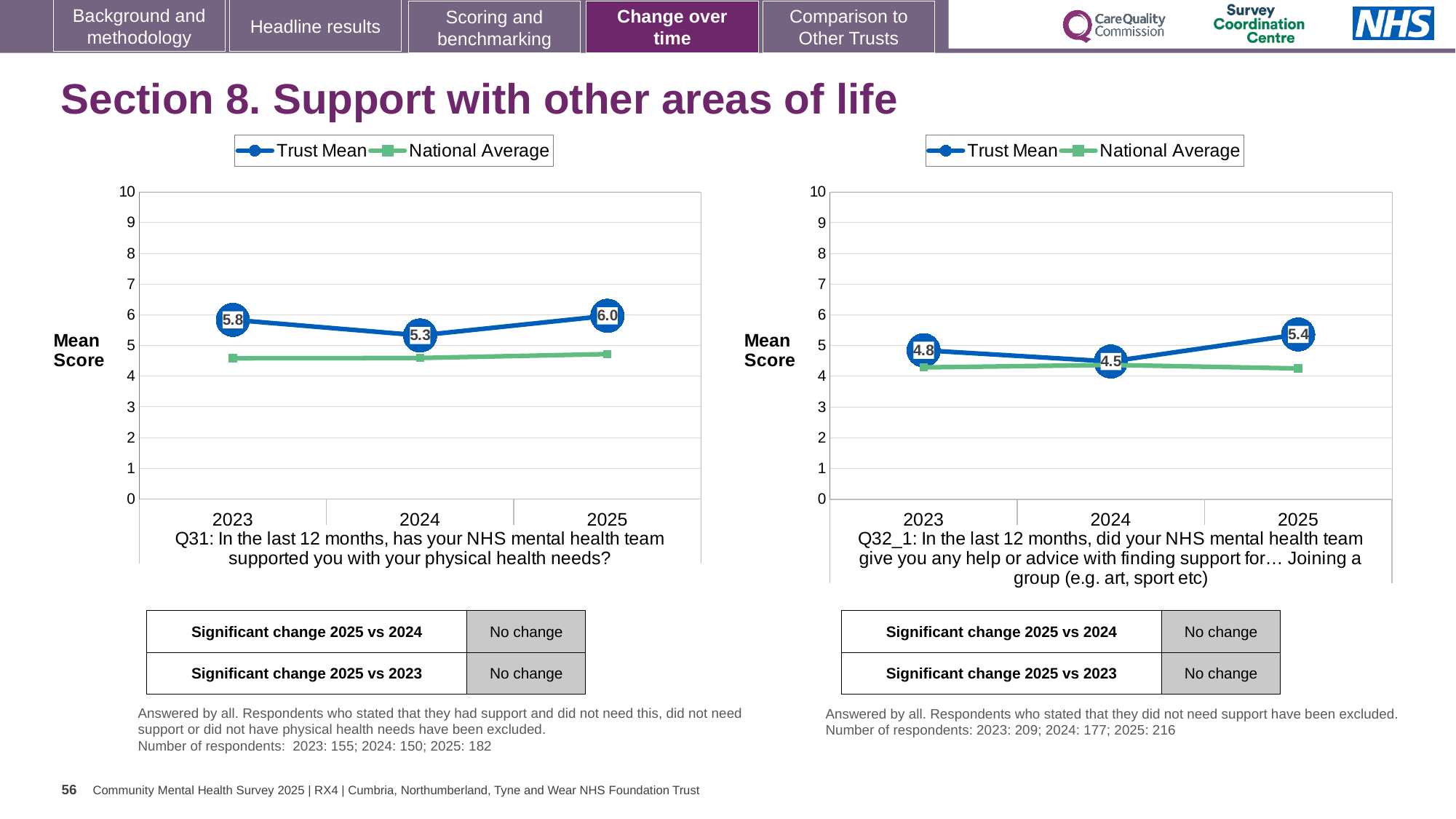
On the left chart (Q31), what is the Trust Mean for 2024? 5.3 On the left chart (Q31), in which year is the Trust Mean lowest? 2024 How many series does the legend of the left chart (Q31) list? 2 On the left chart (Q31), what is the Trust Mean for 2025? 6.0 On the right chart (Q32_1), what is the Trust Mean for 2023? 4.8 On the left chart (Q31), is the National Average for 2025 greater or less than 5? less On the left chart (Q31), which is larger, the Trust Mean in 2023 or in 2024? 2023 On the right chart (Q32_1), in which year is the Trust Mean highest? 2025 What kind of chart is the right chart (Q32_1)? Line chart On the right chart (Q32_1), does the Trust Mean rise or fall from 2024 to 2025? Rise How many years are plotted on the x axis of the right chart (Q32_1)? 3 On the right chart (Q32_1), what is the difference between the Trust Mean in 2025 and in 2024? 0.9